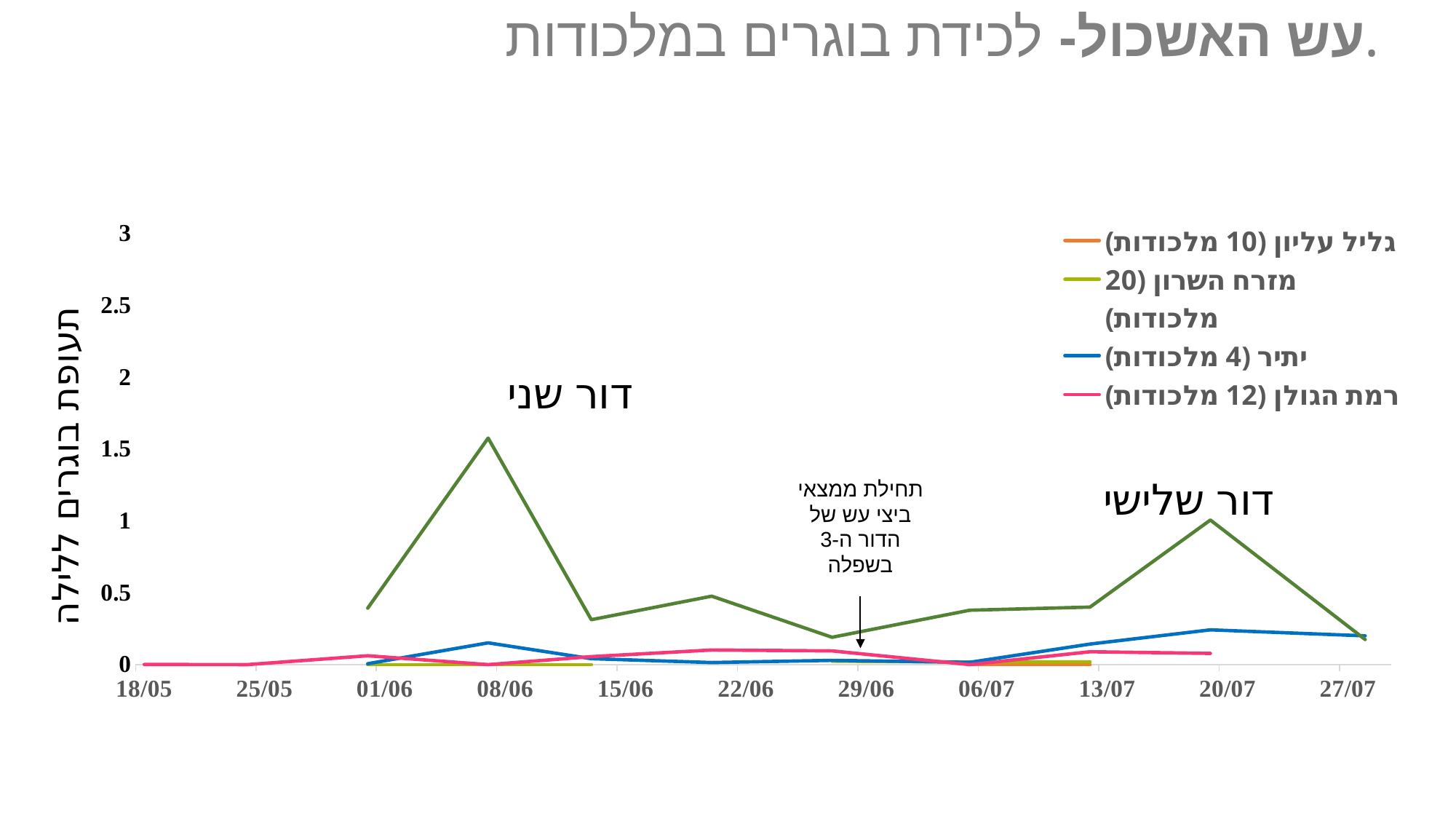
How many date labels are shown along the x axis? 11 What label is written above the first peak of the dark green line, near 08/06? דור שני Does the dark green line rise or fall between 08/06 and 15/06? fall Is the value of the רמת הגולן (12 מלכודות) line at 22/06 greater or less than 0.5? less At which date does the dark green line reach its highest value? 08/06 Does the dark green line rise or fall between 06/07 and 20/07? rise Is the value of the dark green line at 15/06 greater or less than 0.5? less Is the value of the יתיר (4 מלכודות) line at 20/07 greater or less than 0.5? less What type of chart is shown on the slide? line chart Which legend entry corresponds to the blue line? יתיר (4 מלכודות) How many series does the legend list? 4